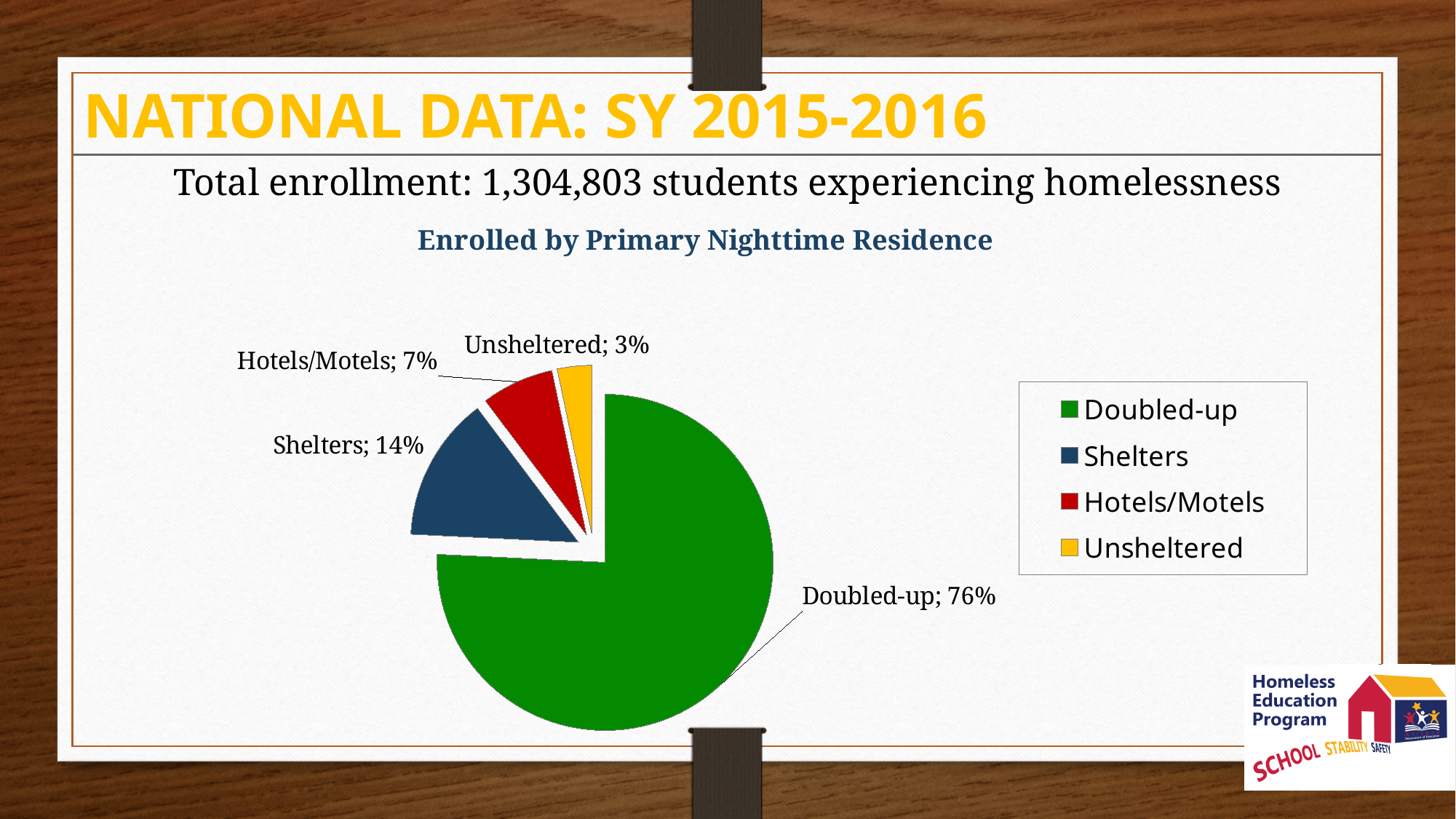
Which category has the largest slice of the pie? Doubled-up What colour is the Shelters slice in the legend? dark blue What share of the pie is Hotels/Motels? 7% What is the difference in percentage points between Shelters and Hotels/Motels? 7% What share of the pie is Doubled-up? 76% Which category has the smallest slice of the pie? Unsheltered What share of the pie is Shelters? 14% What is the title of the chart? Enrolled by Primary Nighttime Residence What type of chart is shown on the slide? pie chart How many categories does the pie chart show? 4 Which is larger, the share for Hotels/Motels or the share for Unsheltered? Hotels/Motels